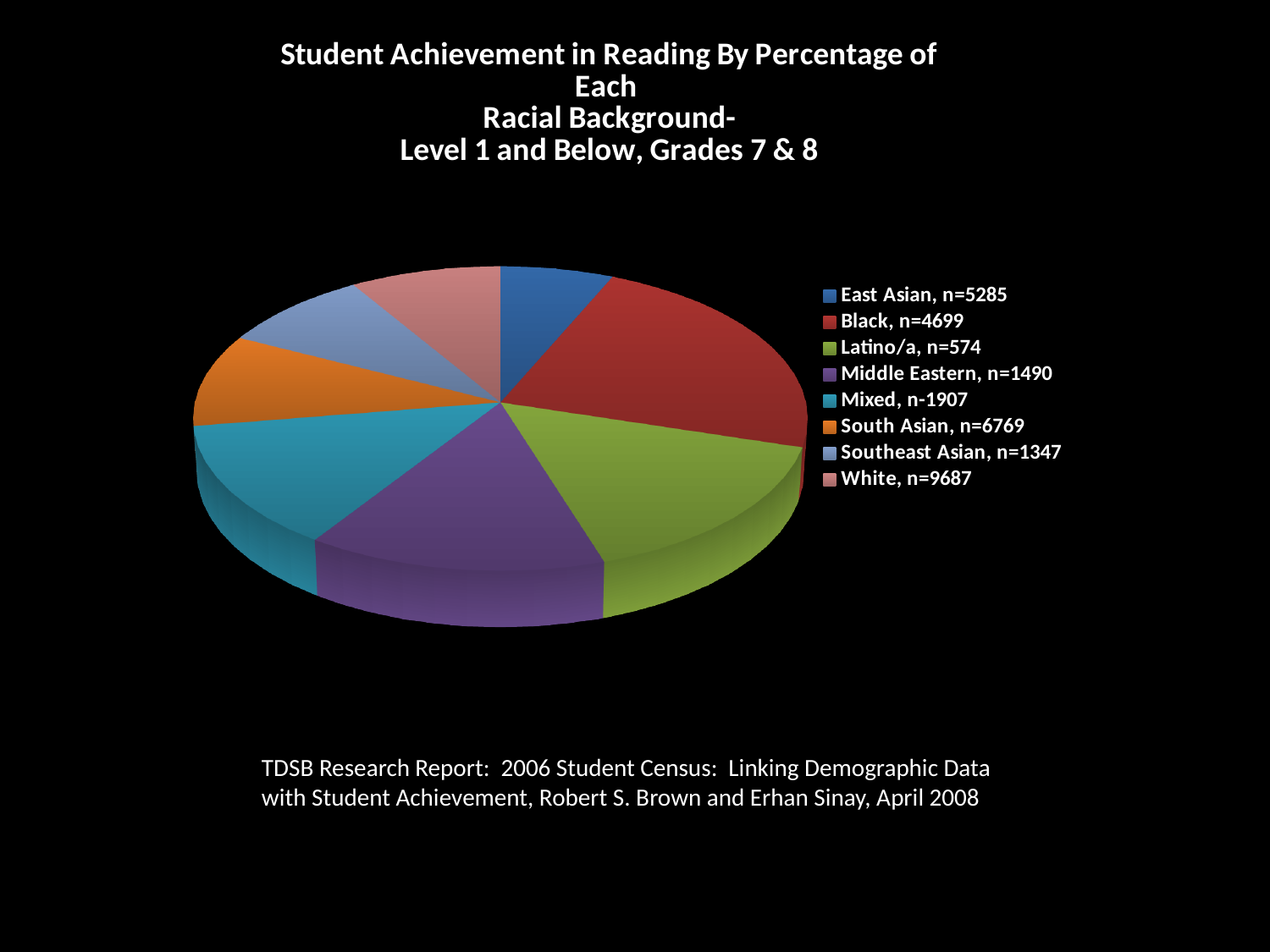
What kind of chart is shown on the slide? pie chart Which slice is larger, Black or East Asian? Black What colour is the Black category slice in the pie chart? red Which slice is larger, Latino/a or South Asian? Latino/a Which slice is larger, Middle Eastern or White? Middle Eastern How many racial background categories does the pie chart show? 8 According to the legend, what is the n value for the White category? n=9687 Which racial background has the largest slice of the pie chart? Black